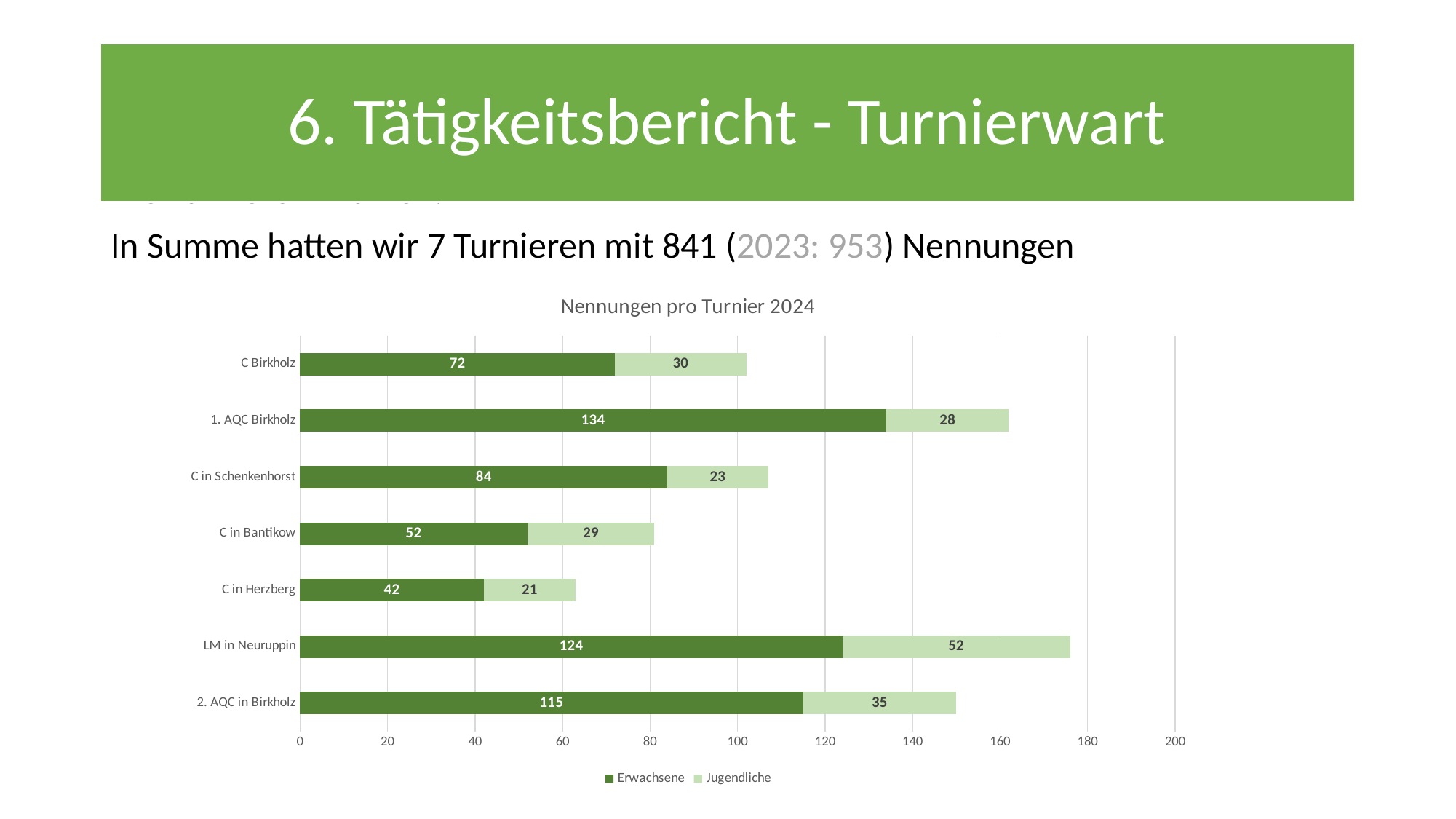
What is the total of the stacked bar for LM in Neuruppin? 176 What is the Erwachsene value for C in Herzberg? 42 What is the Jugendliche value for LM in Neuruppin? 52 Which tournament has the lowest Jugendliche value? C in Herzberg What is the total of the stacked bar for C in Schenkenhorst? 107 What is the Erwachsene value for 1. AQC Birkholz? 134 What type of chart is shown? Stacked bar chart Which tournament has the highest Erwachsene value? 1. AQC Birkholz What is the difference between the Erwachsene values for LM in Neuruppin and 2. AQC in Birkholz? 9 How many tournaments are shown in the chart? 7 Which is larger, the Jugendliche value for C Birkholz or for C in Bantikow? C Birkholz How many series does the legend list? 2